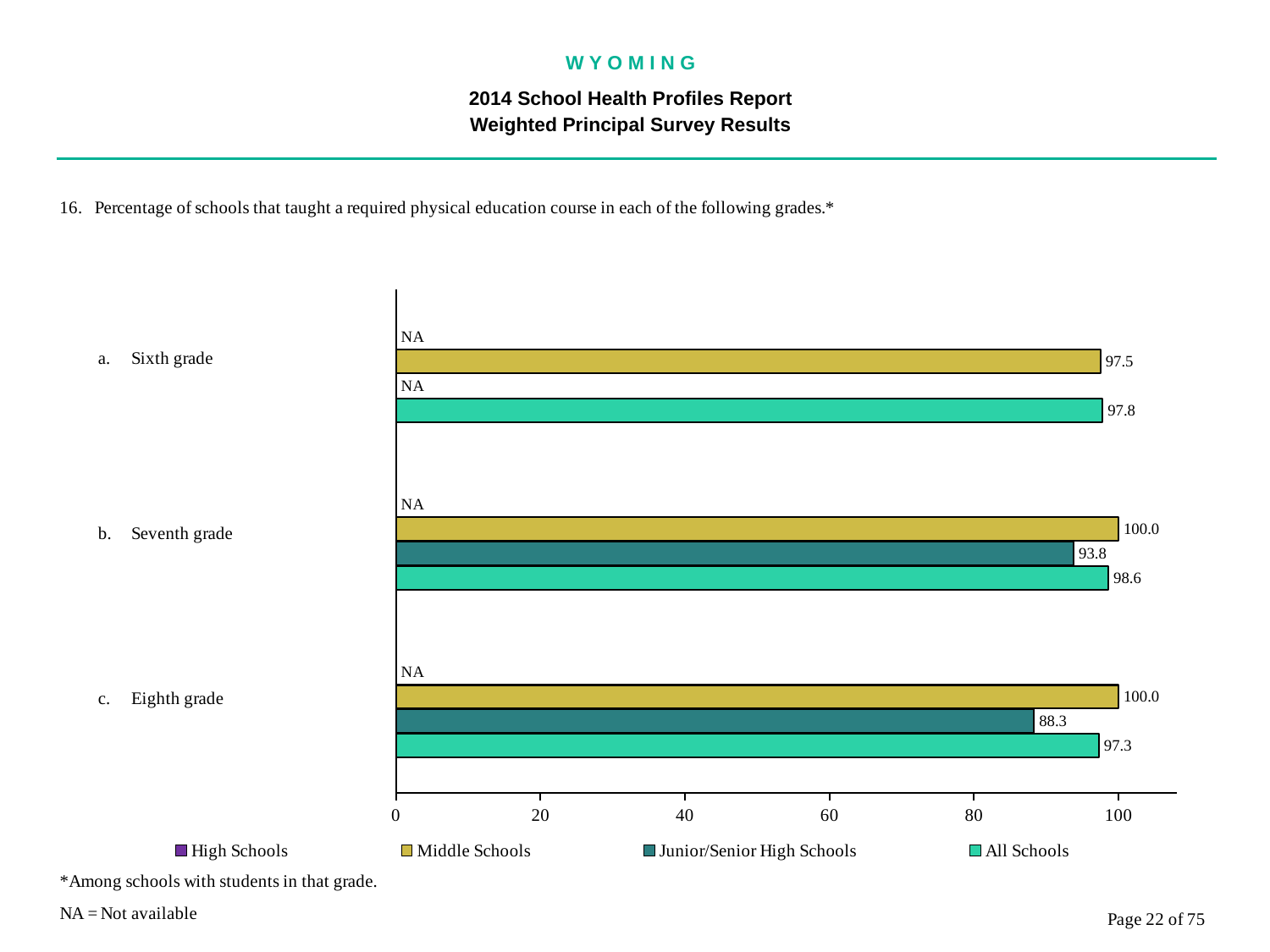
What kind of chart is shown on the slide? bar chart Is the value for Junior/Senior High Schools for Eighth grade greater or less than 80? greater Which series is shown as NA for every grade? High Schools What is the value for Junior/Senior High Schools for Sixth grade? NA Which grade has the lowest value for Junior/Senior High Schools among those with a numeric value? Eighth grade How many series does the legend list? 4 What is the difference between the Middle Schools and Junior/Senior High Schools values for Eighth grade? 11.7 How many grade categories are shown on the chart? 3 What is the value for Junior/Senior High Schools for Eighth grade? 88.3 What is the value for All Schools for Seventh grade? 98.6 Which is larger for Seventh grade: Middle Schools or Junior/Senior High Schools? Middle Schools What is the value for Middle Schools for Sixth grade? 97.5